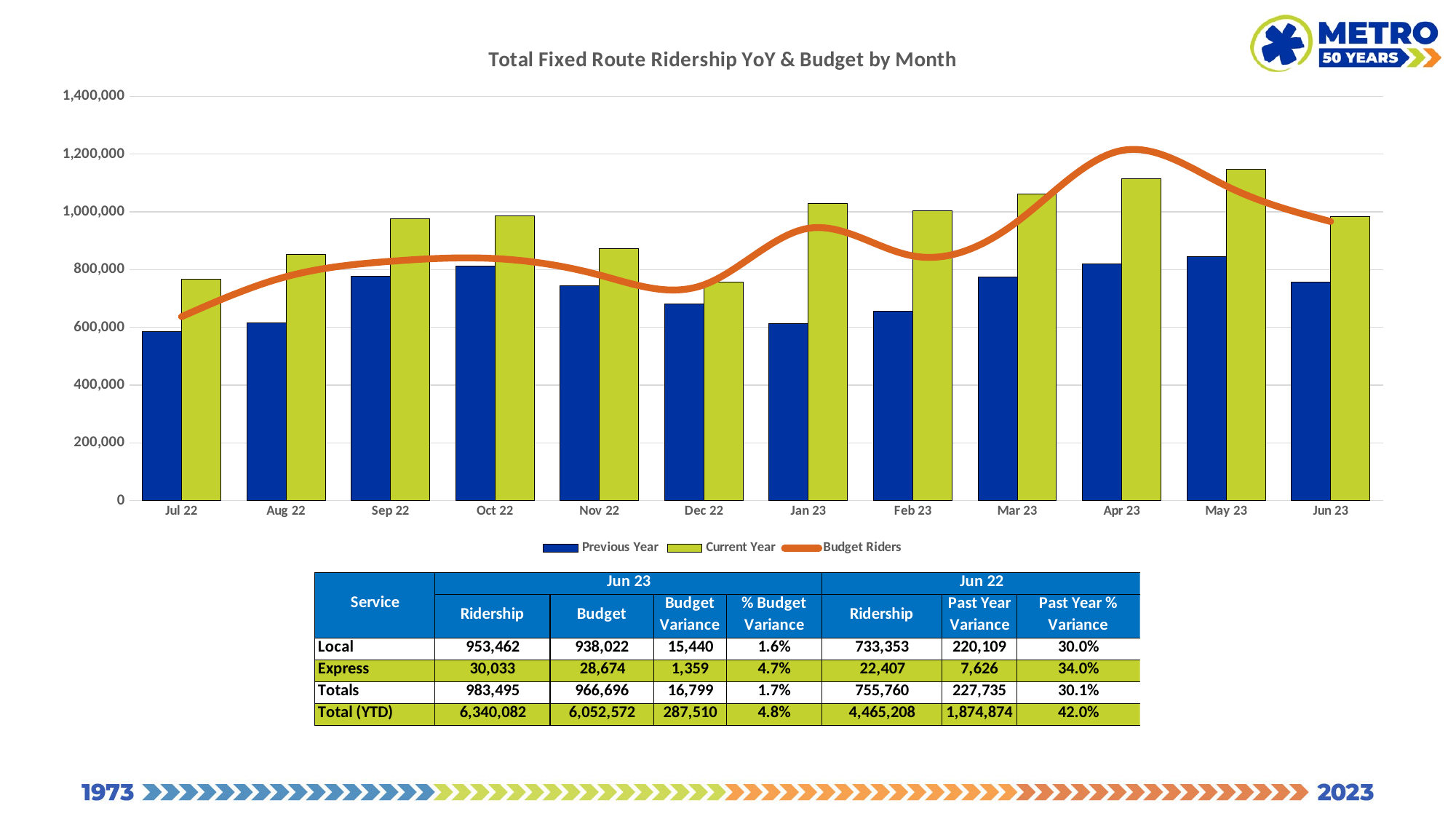
Which is larger, the Current Year value for Mar 23 or for Jun 23? Mar 23 What is the title of the chart? Total Fixed Route Ridership YoY & Budget by Month In which month is the Previous Year bar lowest? Jul 22 What kind of chart is used for the Previous Year and Current Year series? Bar chart How many months are shown on the x axis of the chart? 12 Which series is drawn as an orange line on the chart? Budget Riders Is the Previous Year value for Jul 22 greater or less than 600,000? less How many series does the chart legend list? 3 In which month is the Previous Year bar highest? May 23 In which month is the Current Year bar highest? May 23 Is the Budget Riders value for Dec 22 greater or less than 800,000? less Is the Current Year value for Jan 23 greater or less than 1,000,000? greater